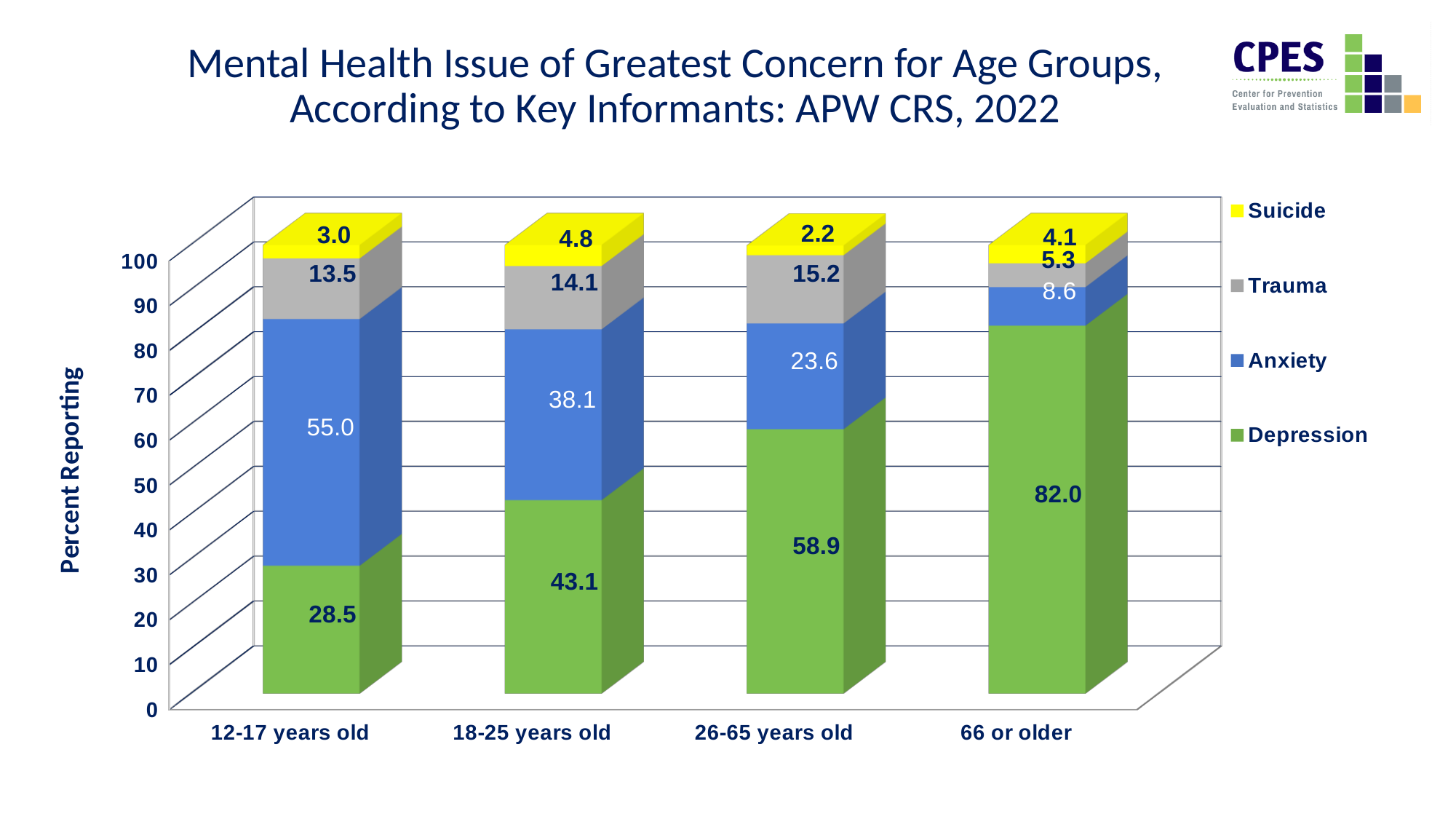
What is the Anxiety value for the 12-17 years old group? 55.0 How many series does the legend list? 4 Does the Depression value rise or fall as the age groups move from 12-17 years old to 66 or older? Rises What is the Depression value for the 66 or older age group? 82.0 What kind of chart is shown on the slide? Stacked bar chart What is the difference between the Depression value for 66 or older and the Depression value for 12-17 years old? 53.5 Which age group has the highest Depression value? 66 or older Which has the larger Anxiety value, 18-25 years old or 26-65 years old? 18-25 years old What is the Trauma value for the 26-65 years old group? 15.2 Which age group has the lowest Suicide value? 26-65 years old How many age groups are shown on the x axis? 4 What is the Suicide value for the 18-25 years old group? 4.8